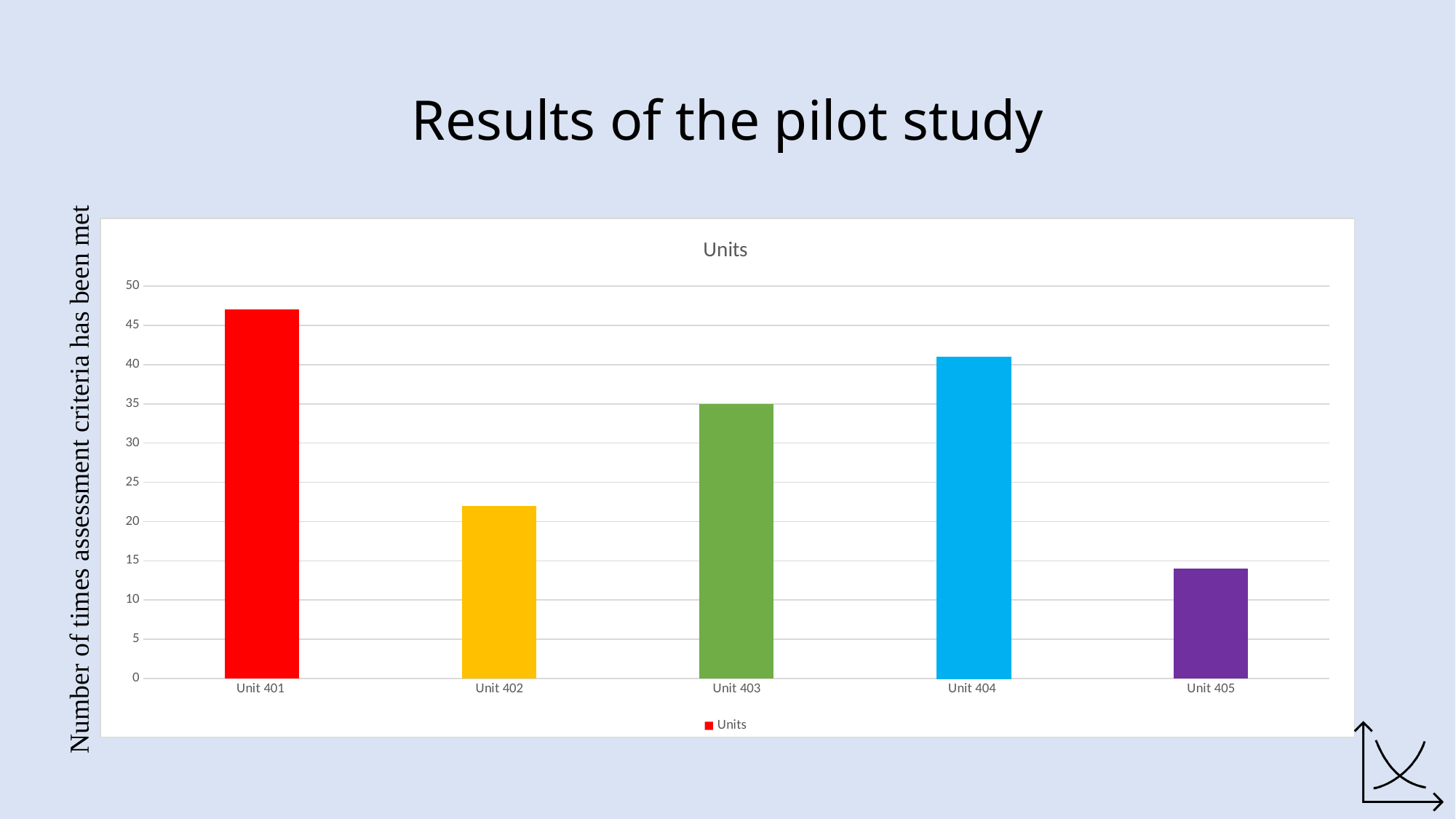
Is the value for Unit 402 greater or less than 25? less Which has a larger value, Unit 402 or Unit 404? Unit 404 What is the value for Unit 403? 35 Which unit has the highest number of times assessment criteria has been met? Unit 401 What type of chart is shown on the slide? bar chart How many units are shown on the x axis of the chart? 5 Which unit has the lowest number of times assessment criteria has been met? Unit 405 Is the value for Unit 401 greater or less than 45? greater What is the title of the chart? Units How many series does the legend list? 1